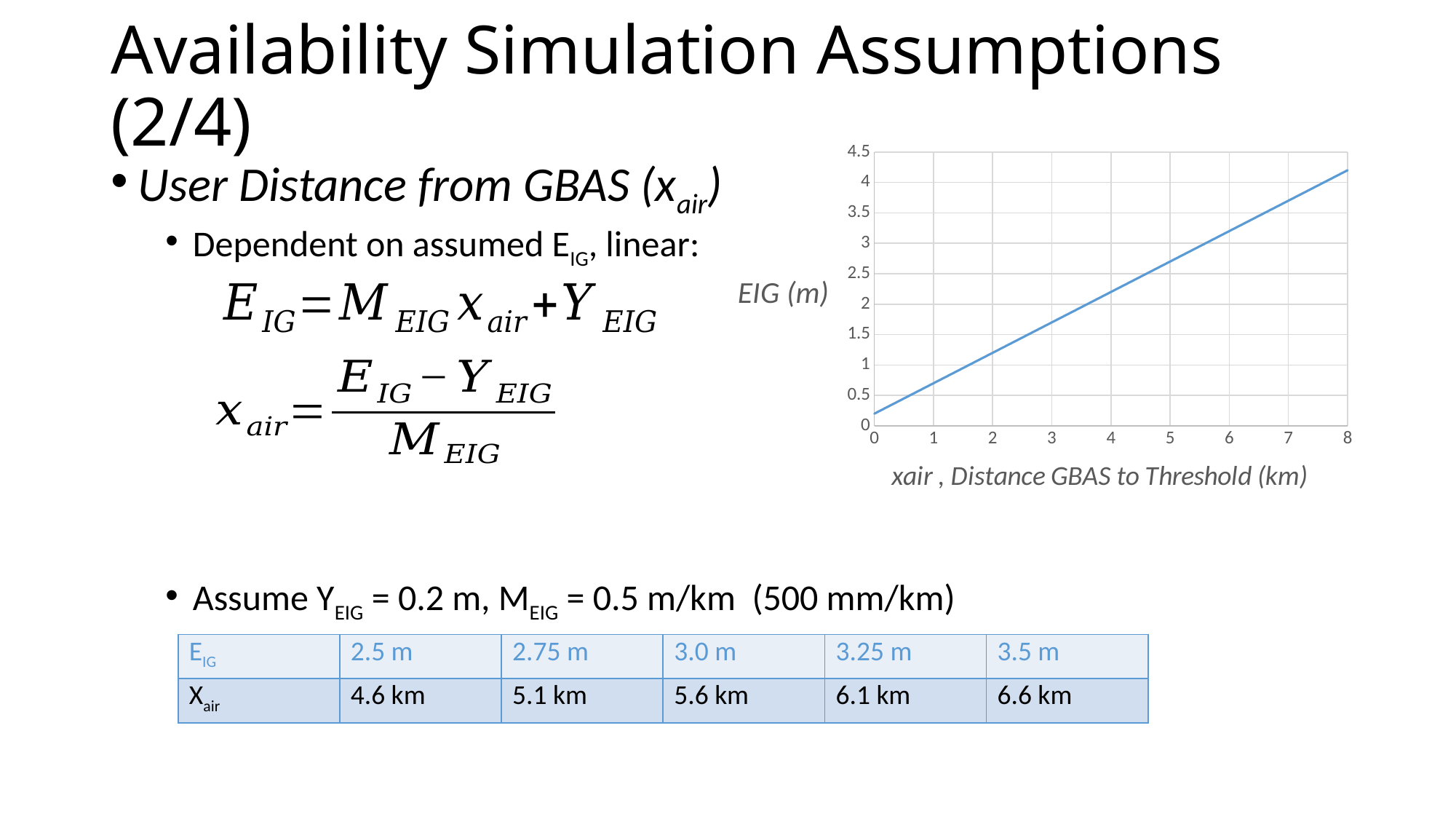
Which end of the line has the higher EIG value, xair = 0 km or xair = 8 km? xair = 8 km Is the value of EIG at xair = 1 km greater or less than 1? less Is the value of EIG at xair = 6 km greater or less than 3.5? less What is the label of the y axis of the chart? EIG (m) Is the value of EIG at xair = 8 km greater or less than 4? greater Does the plotted line rise or fall as xair increases along the x axis? rise What is the label of the x axis of the chart? xair , Distance GBAS to Threshold (km) What kind of chart is shown on the slide? line chart What is the highest tick value shown on the y axis of the chart? 4.5